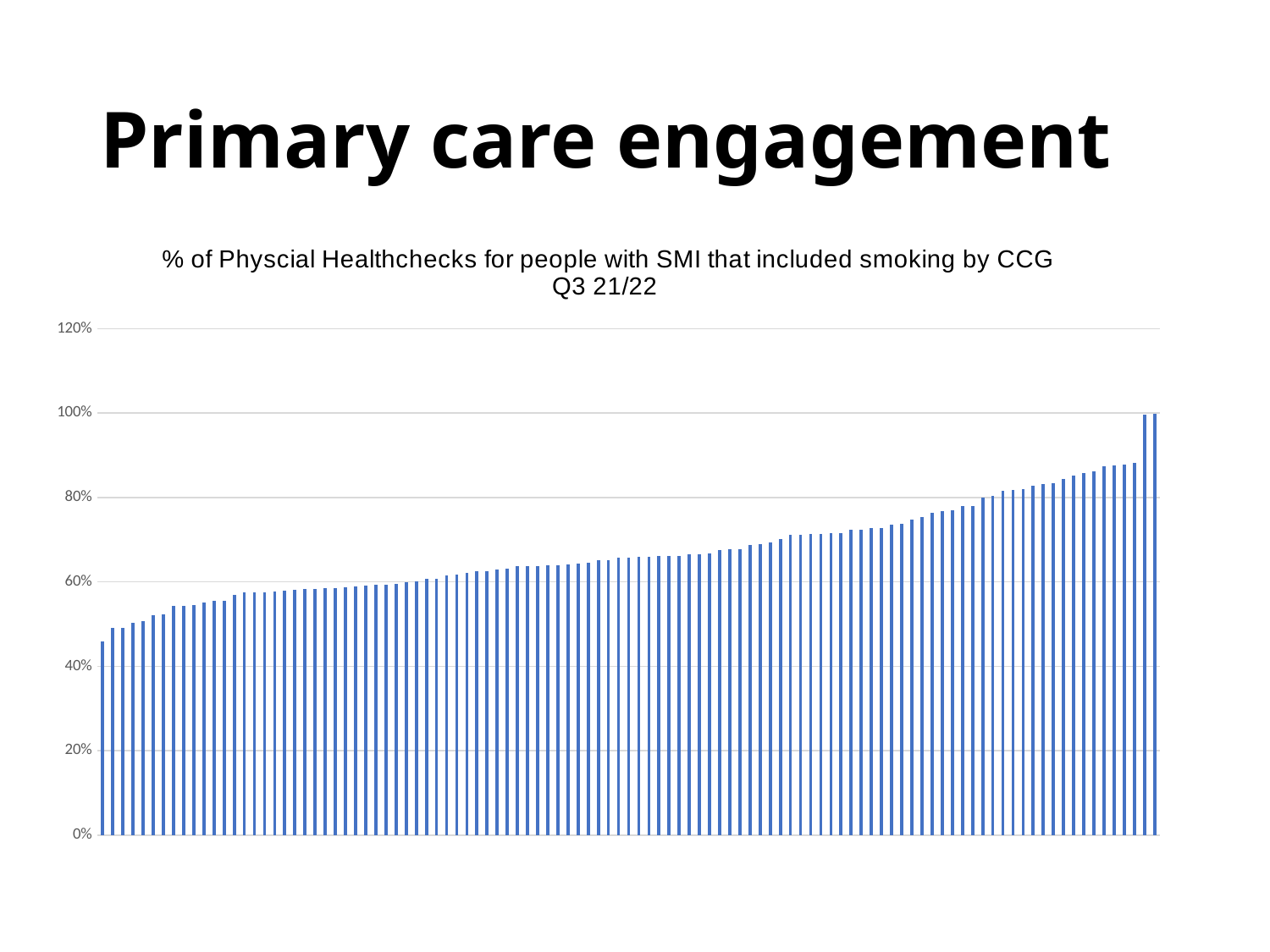
What is the title of the chart? % of Physcial Healthchecks for people with SMI that included smoking by CCG Q3 21/22 What is the highest value shown on the vertical axis? 120% Which bar is the tallest: the leftmost bar or the rightmost bar? the rightmost bar Do the bar values rise or fall from left to right across the chart? rise Is the value of the bar in the middle of the chart greater or less than 80%? less Is the value of the leftmost bar greater or less than 60%? less Is the value of the leftmost bar greater or less than 40%? greater What kind of chart is shown on the slide? bar chart